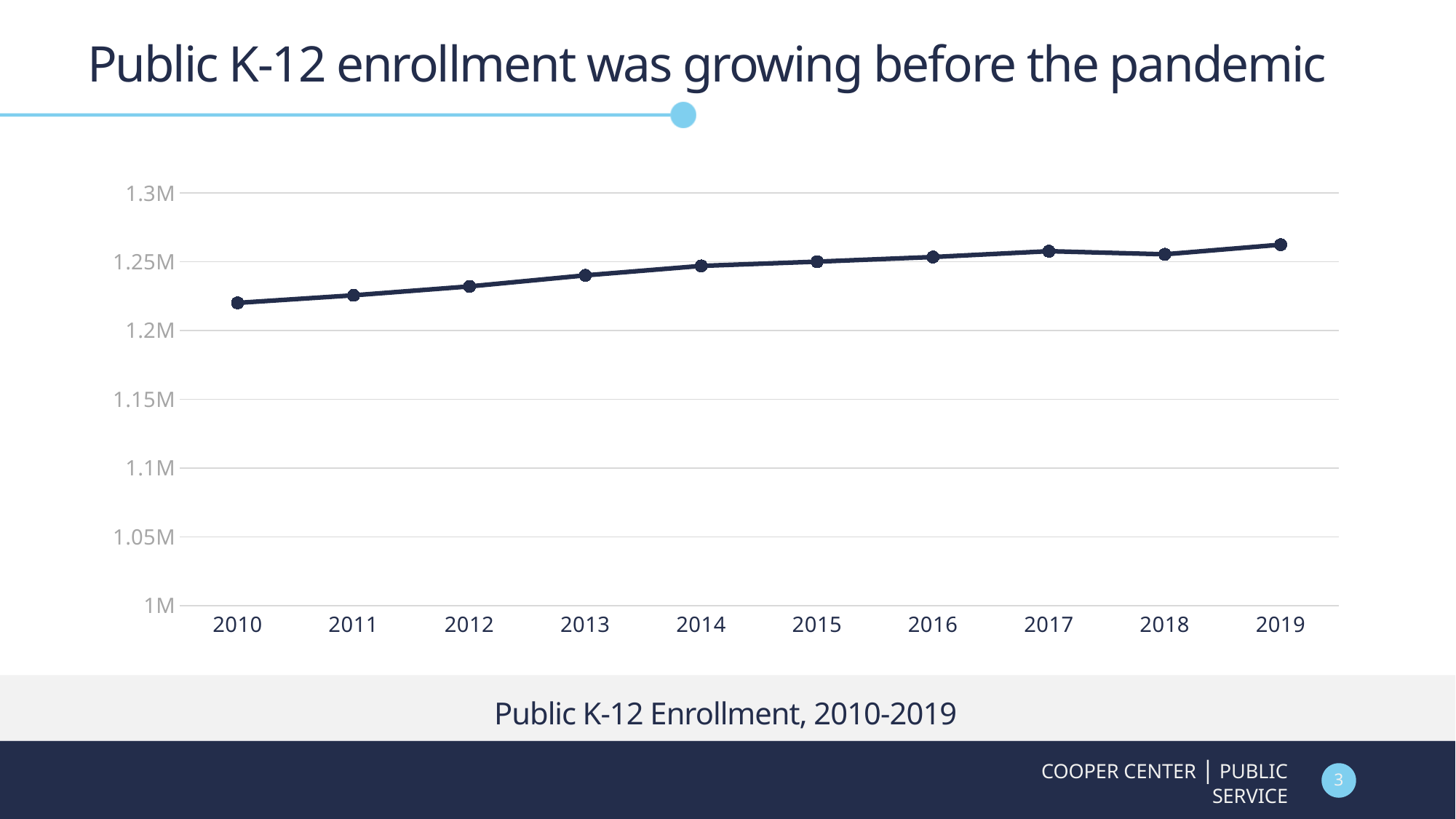
How many data points are plotted on the line? 10 Do the enrollment values generally rise or fall from 2010 to 2019? rise Is the value for 2010 greater or less than 1.2M? greater What is the caption shown below the chart? Public K-12 Enrollment, 2010-2019 Which year has the lowest enrollment? 2010 Is the value for 2019 greater or less than 1.25M? greater Which year has the larger enrollment, 2017 or 2018? 2017 Is the value for 2010 greater or less than 1.25M? less What kind of chart is shown on the slide? line chart Which year has the highest enrollment? 2019